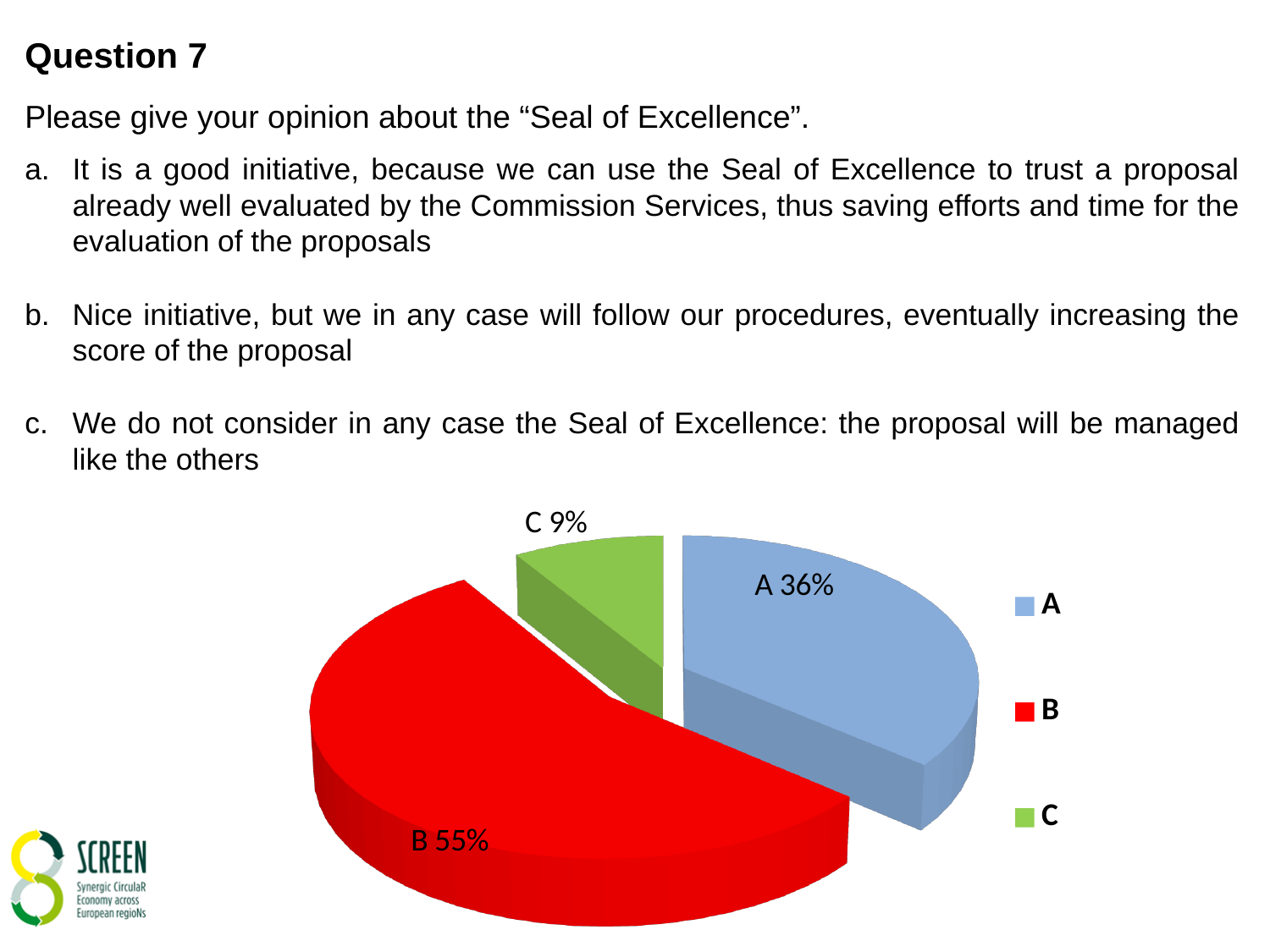
What percentage of the pie does slice C represent? 9% Which is larger, slice A or slice C? A What percentage of the pie does slice A represent? 36% How many slices does the pie chart have? 3 Which slice is the smallest in the pie chart? C What kind of chart is shown on the slide? pie chart How many entries does the legend list? 3 What percentage of the pie does slice B represent? 55% What is the difference in percentage points between slice A and slice C? 27 What is the difference in percentage points between slice B and slice A? 19 Which slice is the largest in the pie chart? B What colour is slice B in the pie chart? red